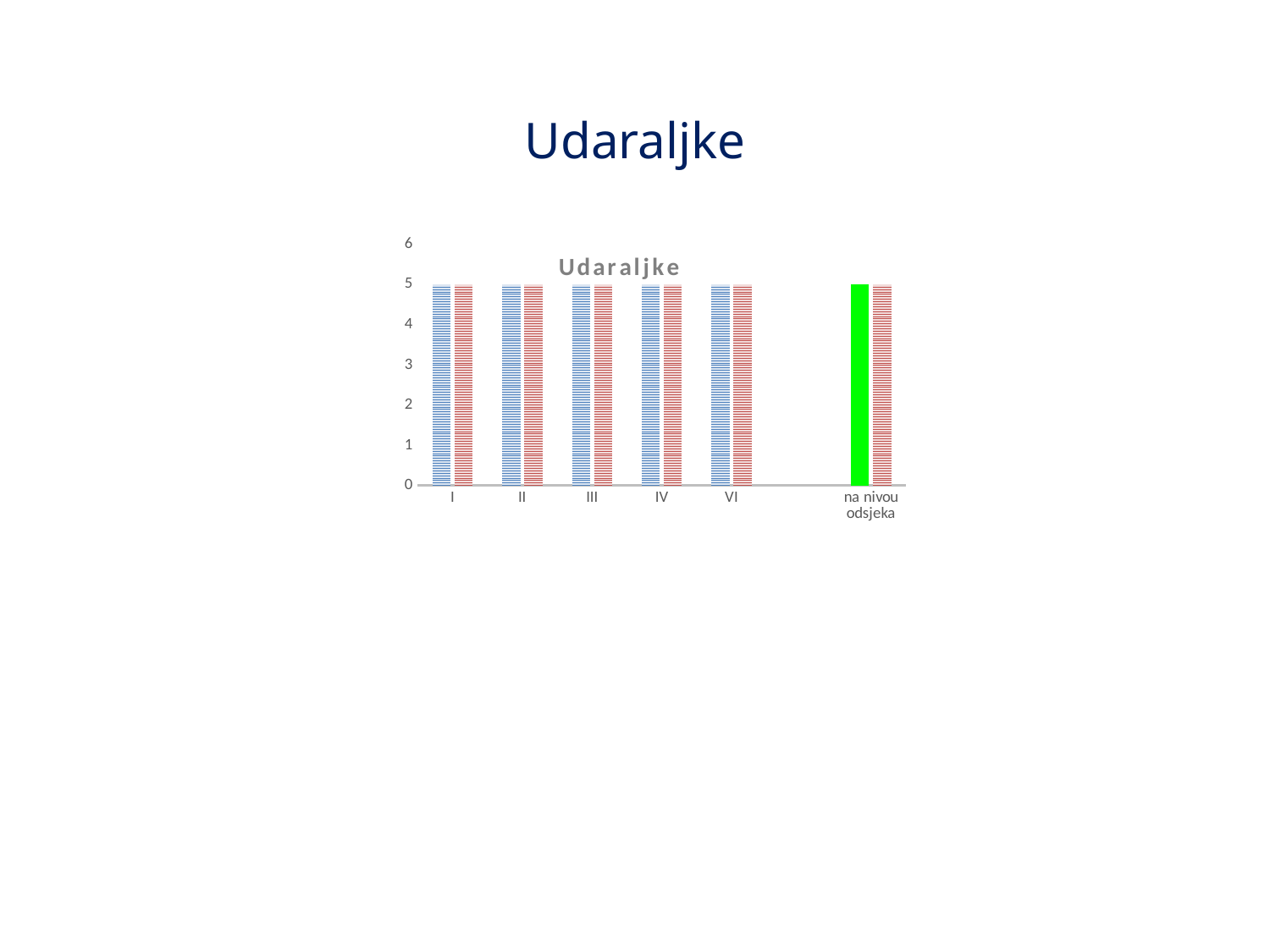
What value does the red bar for category III reach? 5 What is the difference between the blue bar for category I and the red bar for category V I? 0 What value does the green bar for 'na nivou odsjeka' reach? 5 What is the title of the chart? Udaraljke Do the bar values rise, fall, or stay the same across the categories from I to VI? stay the same Is the value for category IV greater or less than 4? greater What value does the blue bar for category VI reach? 5 Is the value for category II greater or less than 6? less What kind of chart is shown on the slide? bar chart What value does the blue bar for category I reach? 5 How many categories are shown on the x axis of the chart? 6 What is the highest value shown on the vertical axis? 6